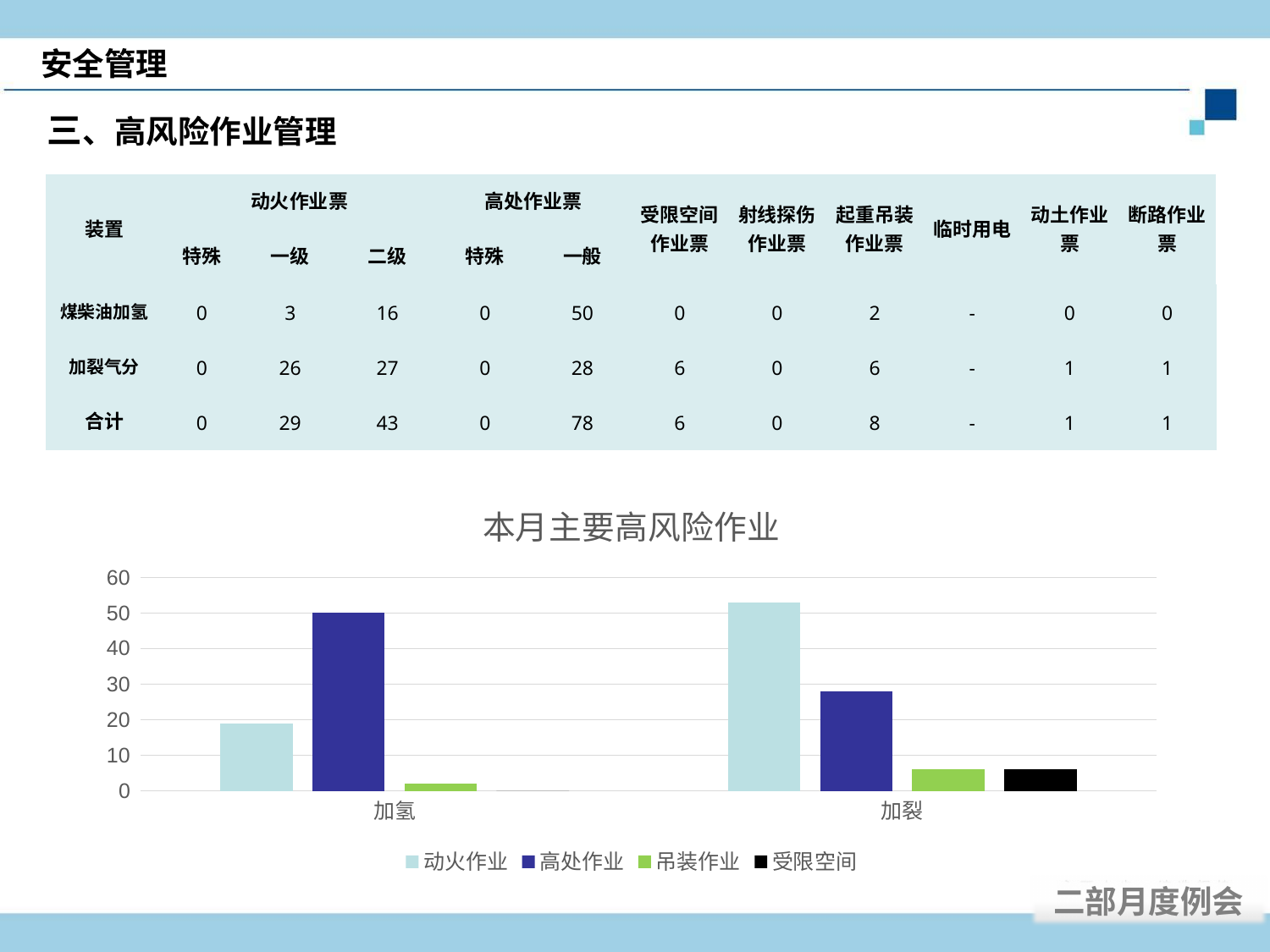
What is the title of the chart? 本月主要高风险作业 Which category has the larger 高处作业 value, 加氢 or 加裂? 加氢 Is the value of 吊装作业 for 加裂 greater or less than 10? less What kind of chart is shown on the slide? bar chart Which bar is the tallest in the chart? 动火作业 for 加裂 Is the value of 动火作业 for 加氢 greater or less than 30? less How many series does the chart legend list? 4 Which category has the larger 动火作业 value, 加氢 or 加裂? 加裂 Which series is shown in black in the chart legend? 受限空间 What is the value of 高处作业 for 加氢 in the chart? 50 How many categories are shown on the x axis of the chart? 2 Is the value of 动火作业 for 加裂 greater or less than 50? greater